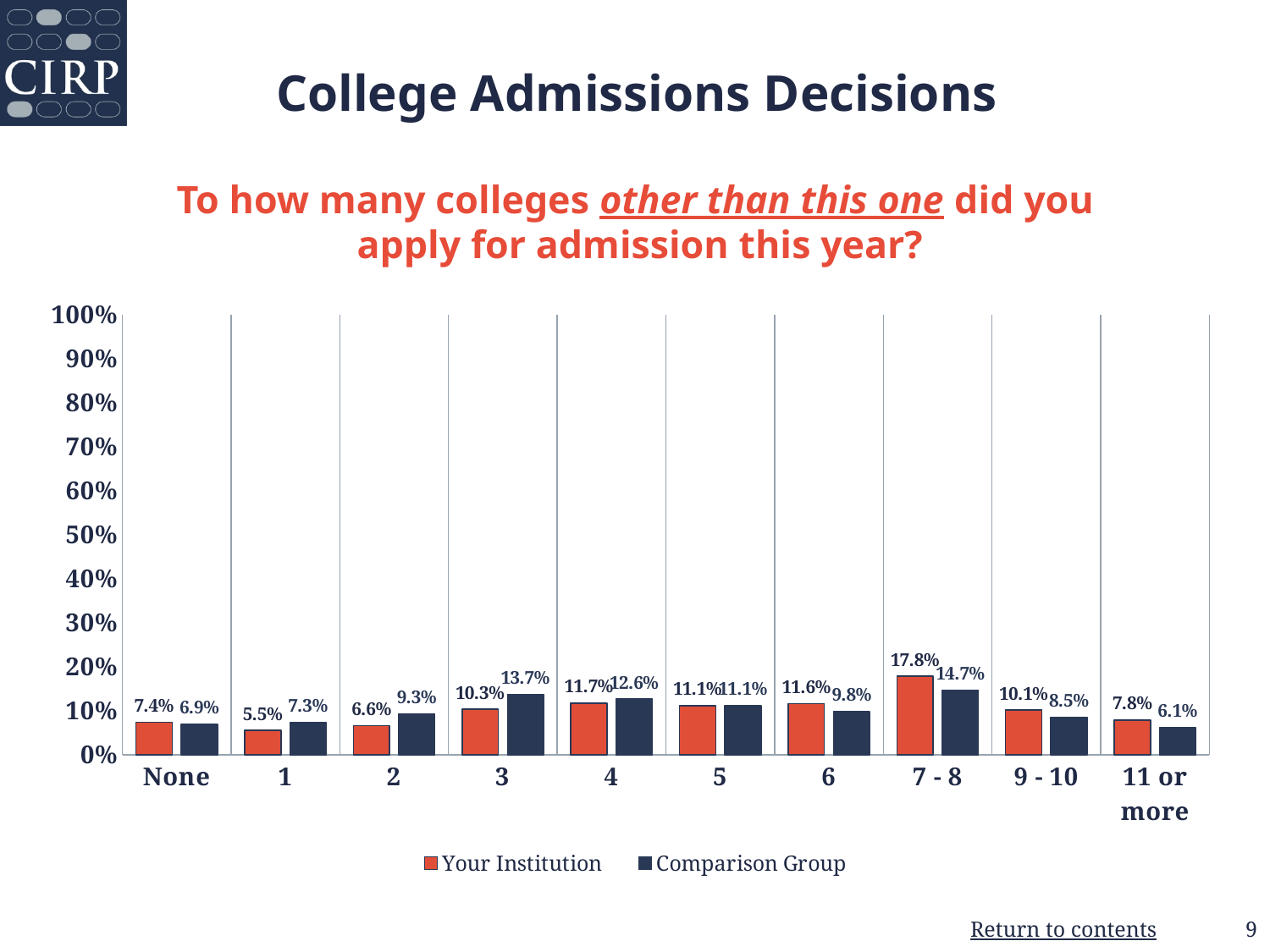
Is the value for Your Institution in the '7 - 8' category greater or less than 20%? less What colour are the bars for Your Institution? orange-red What is the value for Comparison Group in the '3' category? 13.7% What is the difference between Your Institution and Comparison Group in the '2' category? 2.7% Which category has the lowest value for Comparison Group? 11 or more How many series does the legend list? 2 Which category has the highest value for Your Institution? 7 - 8 What is the value for Your Institution in the '7 - 8' category? 17.8% How many categories are shown on the x axis? 10 What is the value for Your Institution in the 'None' category? 7.4% In the '9 - 10' category, which series has the larger value, Your Institution or Comparison Group? Your Institution What kind of chart is shown on the slide? bar chart